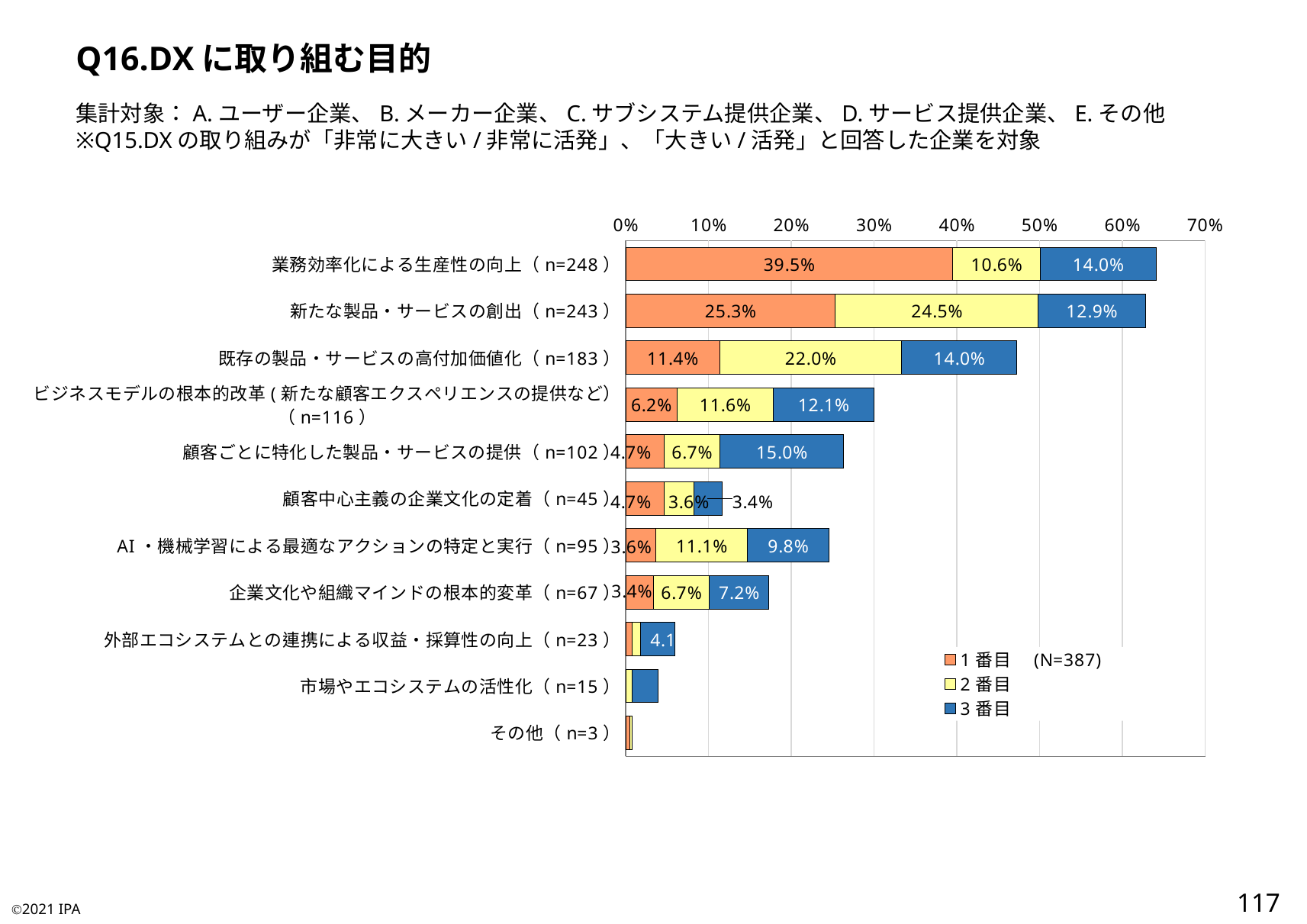
What is the 3番目 value for 顧客ごとに特化した製品・サービスの提供 (n=102)? 15.0% What is the total of the stacked bar for 既存の製品・サービスの高付加価値化 (n=183)? 47.4% What is the difference between the 1番目 values for 業務効率化による生産性の向上 and 新たな製品・サービスの創出? 14.2% Which category has the highest 2番目 value? 新たな製品・サービスの創出 (n=243) How many categories are shown on the chart? 11 Which is larger: the 2番目 value for 既存の製品・サービスの高付加価値化 or the 2番目 value for ビジネスモデルの根本的改革? 既存の製品・サービスの高付加価値化 How many series does the legend list? 3 What kind of chart is shown on the slide? Stacked horizontal bar chart Which category has the highest 1番目 value? 業務効率化による生産性の向上 (n=248) What is the 1番目 value for 業務効率化による生産性の向上 (n=248)? 39.5% Is the total stacked bar for 業務効率化による生産性の向上 greater or less than 60%? greater What is the 2番目 value for 新たな製品・サービスの創出 (n=243)? 24.5%